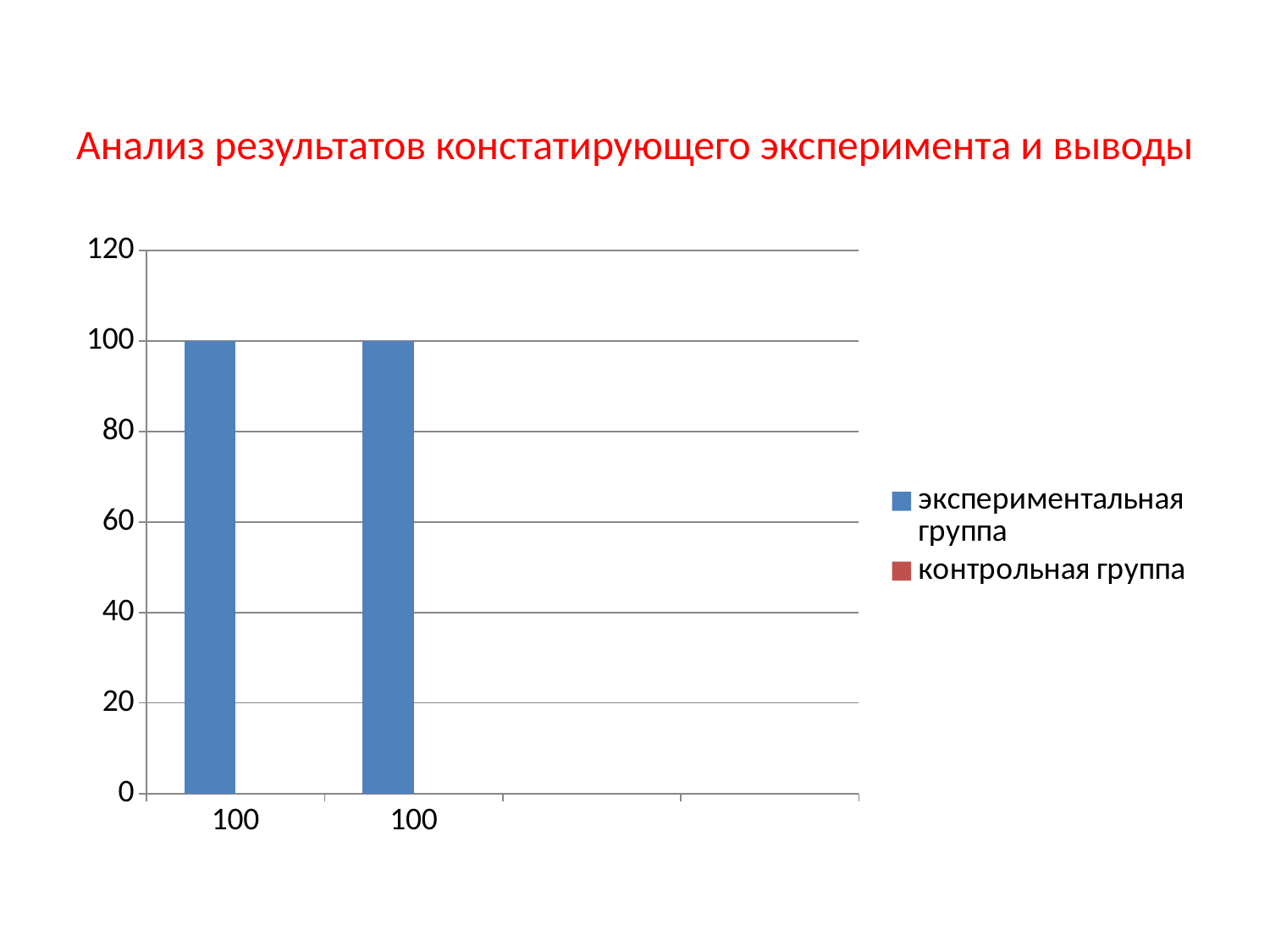
How many series does the legend list? 2 Is the value of the first bar greater or less than 80? greater What is the title of the slide? Анализ результатов констатирующего эксперимента и выводы How many bars are plotted in the chart? 2 What are the two series named in the legend? экспериментальная группа and контрольная группа What kind of chart is shown on the slide? bar chart Is the value of the second bar greater or less than 120? less What is the value of the first (leftmost) bar? 100 What is the value of the second bar? 100 Are the two plotted bars equal in value? yes, both are 100 What is the difference between the values of the first and second bars? 0